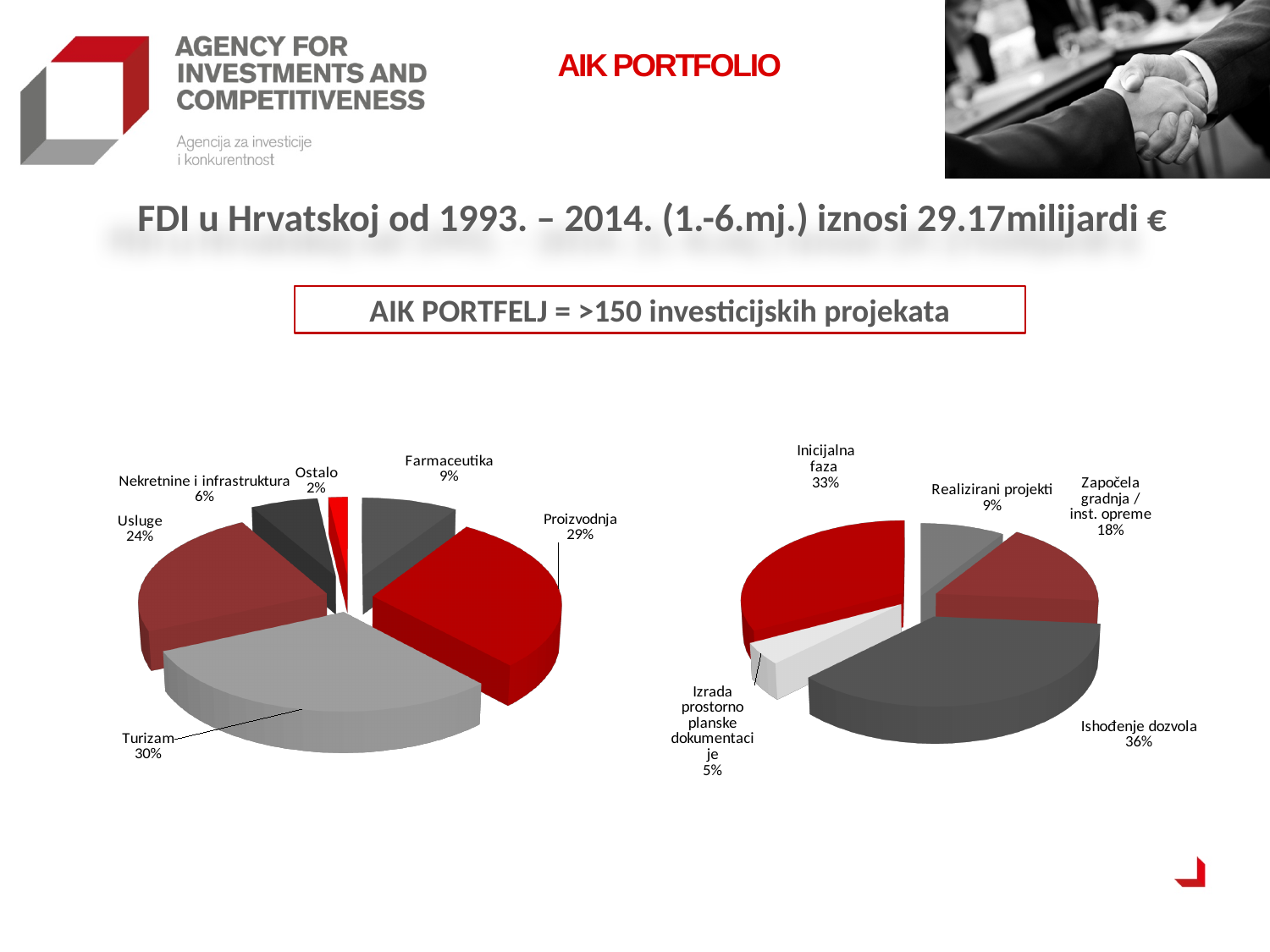
In the left pie chart, what share does Usluge have? 24% How many categories are shown in the left pie chart? 6 How many categories are shown in the right pie chart? 5 In the right pie chart, which is larger: Realizirani projekti or Započela gradnja / inst. opreme? Započela gradnja / inst. opreme In the left pie chart, what is the difference between the shares of Proizvodnja and Farmaceutika? 20% In the right pie chart, which category has the smallest share? Izrada prostorno planske dokumentacije In the right pie chart, what share does Inicijalna faza have? 33% What type of chart is the left chart on the slide? Pie chart In the right pie chart, what share does Ishođenje dozvola have? 36% In the left pie chart, which category has the smallest share? Ostalo In the left pie chart, which category has the largest share? Turizam In the left pie chart, what share does Turizam have? 30%